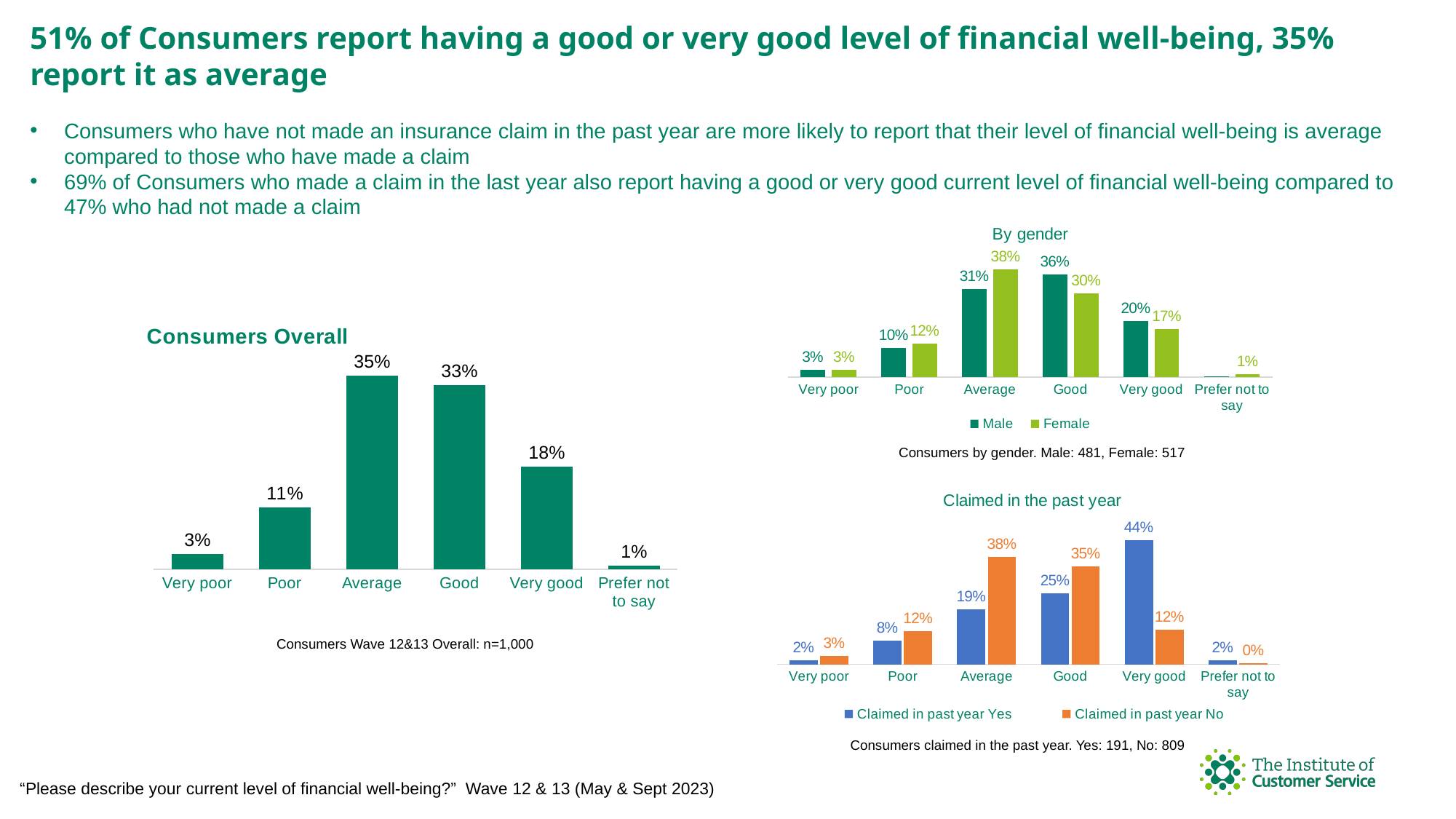
In the 'Consumers Overall' chart, what percentage of consumers rate their financial well-being as Average? 35% In the 'Claimed in the past year' chart, which category has the highest 'Claimed in past year No' value? Average In the 'By gender' chart, what is the difference between the Male and Female values for Very good? 3% In the 'Claimed in the past year' chart, what is the difference between the Yes and No values for Average? 19% In the 'Consumers Overall' chart, which category has the lowest value? Prefer not to say In the 'By gender' chart, how many series does the legend list? 2 In the 'Claimed in the past year' chart, what is the 'Claimed in past year Yes' value for Very good? 44% In the 'By gender' chart, which is larger for Good: Male or Female? Male In the 'By gender' chart, what is the Female value for Average? 38% What kind of chart is the 'Claimed in the past year' chart? Bar chart In the 'Consumers Overall' chart, how many categories are shown on the x axis? 6 In the 'Consumers Overall' chart, what is the difference between the Good and Very good values? 15%